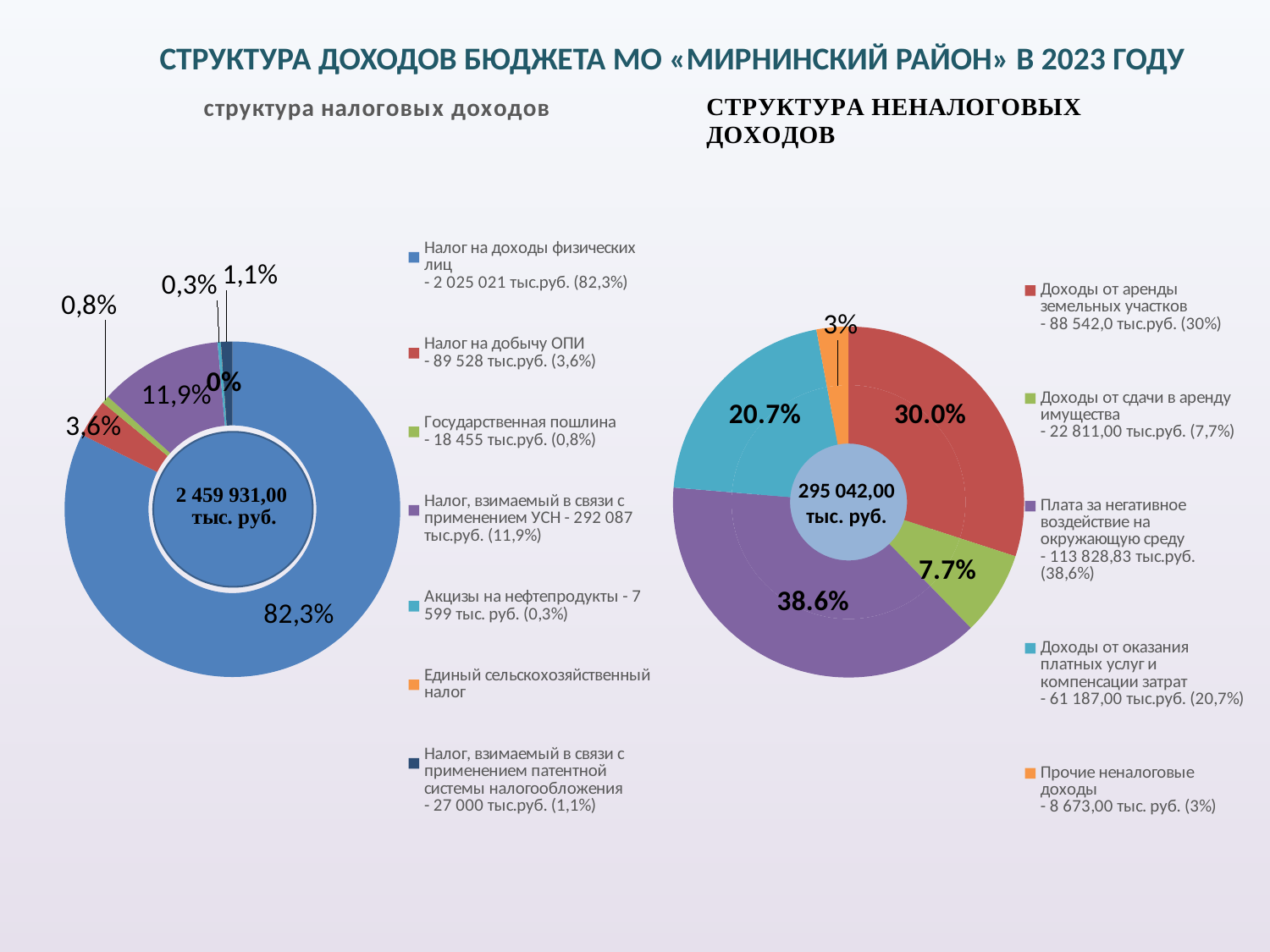
In the left chart (структура налоговых доходов), what share is shown for Налог, взимаемый в связи с применением УСН? 11,9% In the left chart (структура налоговых доходов), what share is shown for Налог на доходы физических лиц? 82,3% In the right chart (СТРУКТУРА НЕНАЛОГОВЫХ ДОХОДОВ), what share is shown for Плата за негативное воздействие на окружающую среду? 38.6% In the right chart (СТРУКТУРА НЕНАЛОГОВЫХ ДОХОДОВ), which is larger: Доходы от оказания платных услуг и компенсации затрат or Доходы от сдачи в аренду имущества? Доходы от оказания платных услуг и компенсации затрат In the left chart (структура налоговых доходов), which category has the largest share? Налог на доходы физических лиц What total value is printed in the centre of the left chart (структура налоговых доходов)? 2 459 931,00 тыс. руб. What type of chart is used for the tax revenue structure (структура налоговых доходов) on the left? doughnut chart In the left chart (структура налоговых доходов), what share is shown for Налог на добычу ОПИ? 3,6% How many slices does the right chart (СТРУКТУРА НЕНАЛОГОВЫХ ДОХОДОВ) have? 5 How many entries does the legend of the left chart (структура налоговых доходов) list? 7 In the right chart (СТРУКТУРА НЕНАЛОГОВЫХ ДОХОДОВ), what share is shown for Доходы от аренды земельных участков? 30.0% In the right chart (СТРУКТУРА НЕНАЛОГОВЫХ ДОХОДОВ), which category has the smallest share? Прочие неналоговые доходы